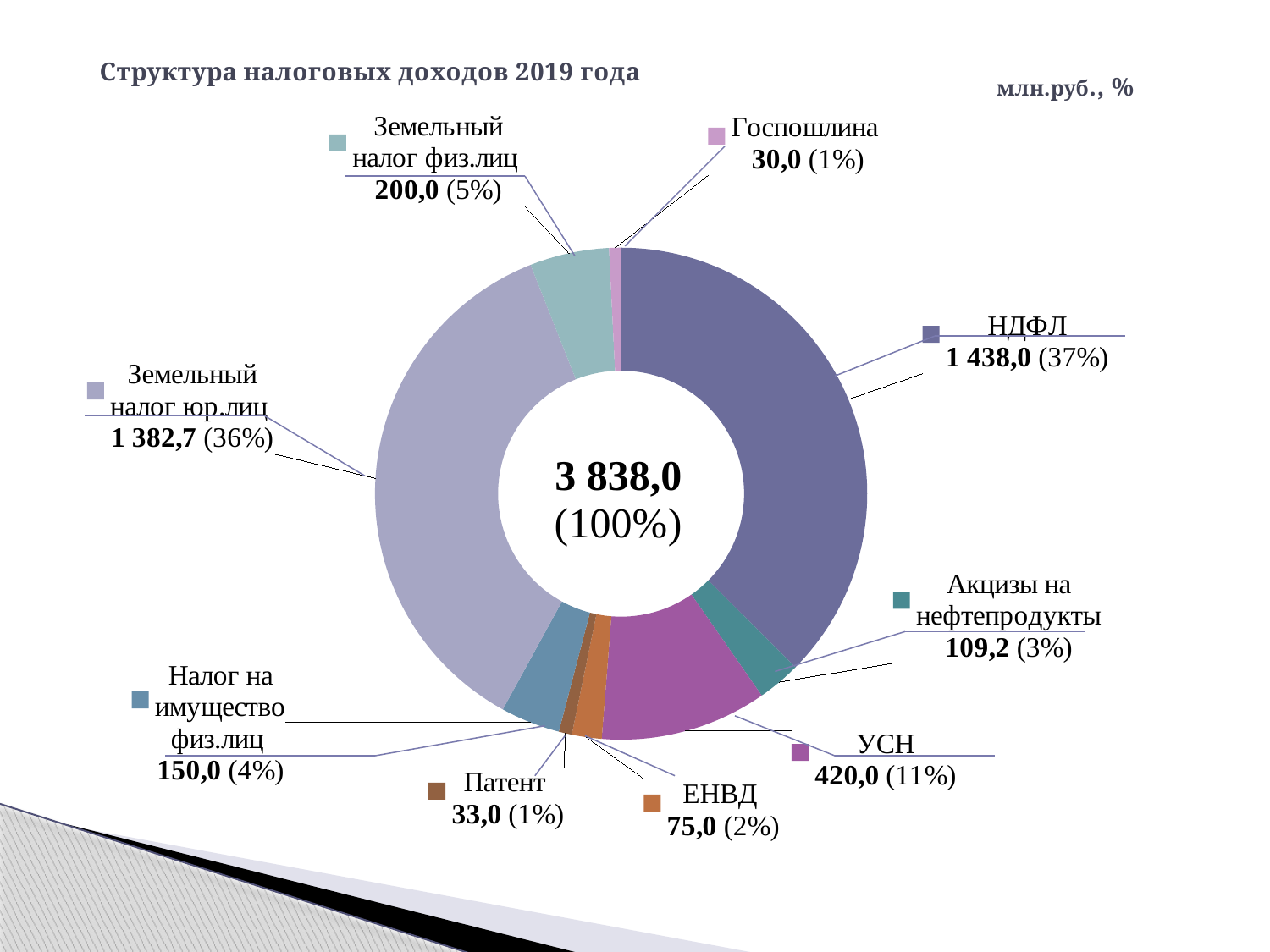
What is the difference between the values for НДФЛ and Земельный налог юр.лиц? 55,3 What share of the total does УСН account for? 11% Which is larger, the value for ЕНВД or the value for Патент? ЕНВД What share of the total does Земельный налог физ.лиц account for? 5% What is the title of the chart? Структура налоговых доходов 2019 года What is the value for Акцизы на нефтепродукты? 109,2 How many categories are shown in the chart? 9 What is the value for НДФЛ? 1 438,0 Which category has the largest value? НДФЛ What kind of chart is shown on the slide? Doughnut chart Which category has the smallest value? Госпошлина What total value is shown in the centre of the chart? 3 838,0